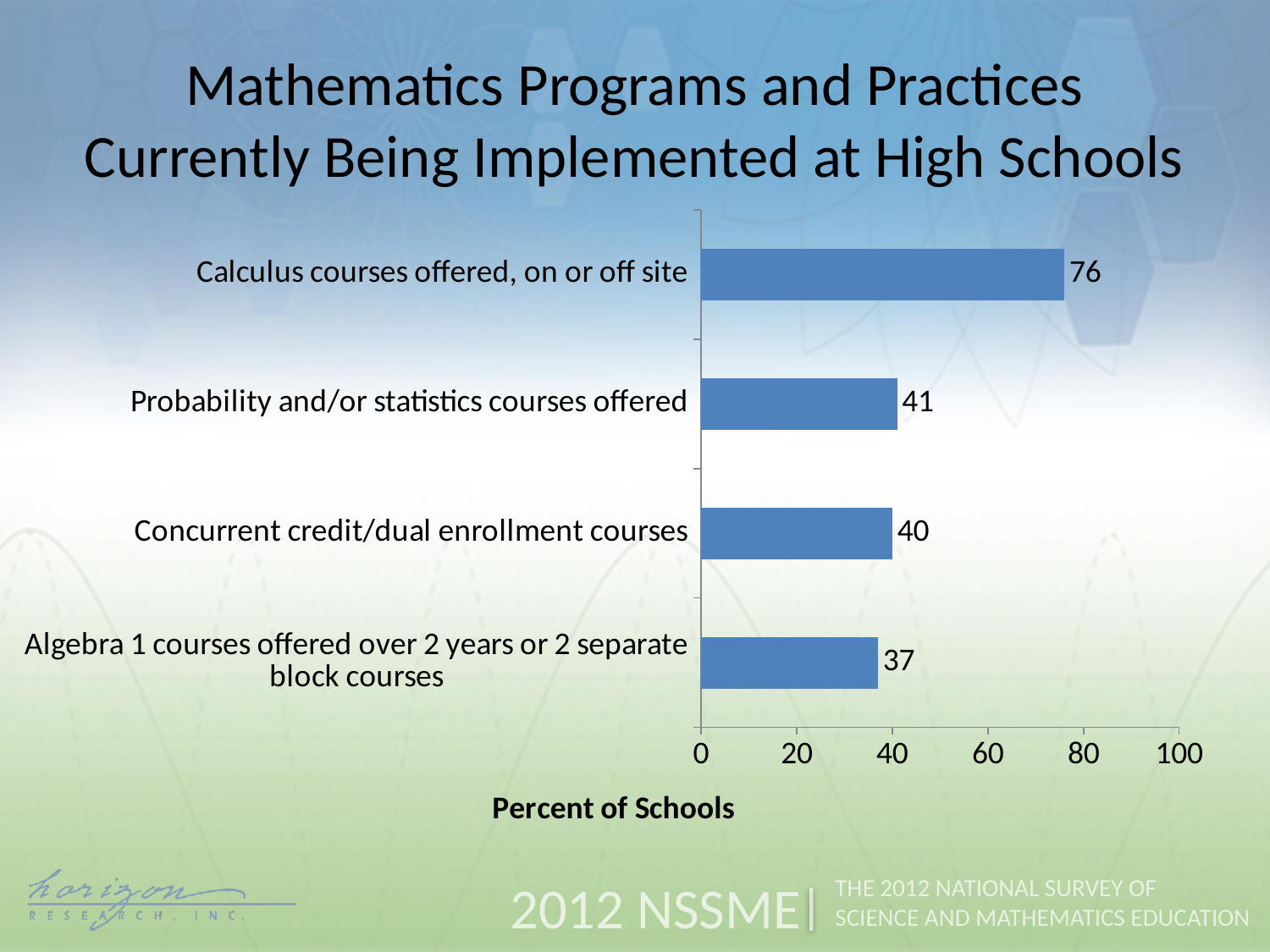
What is the difference between the values for concurrent credit/dual enrollment courses and Algebra 1 courses offered over 2 years or 2 separate block courses? 3 What is the difference between the values for calculus courses offered and probability and/or statistics courses offered? 35 Which is larger: the value for calculus courses offered or the value for concurrent credit/dual enrollment courses? Calculus courses offered, on or off site What is the value for 'Algebra 1 courses offered over 2 years or 2 separate block courses'? 37 What kind of chart is shown on the slide? Bar chart What is the label of the horizontal axis? Percent of Schools Which category has the lowest percent of schools? Algebra 1 courses offered over 2 years or 2 separate block courses Which category has the highest percent of schools? Calculus courses offered, on or off site What is the value for 'Probability and/or statistics courses offered'? 41 What is the value for 'Concurrent credit/dual enrollment courses'? 40 How many categories are shown in the chart? 4 What percent of schools offer calculus courses, on or off site? 76